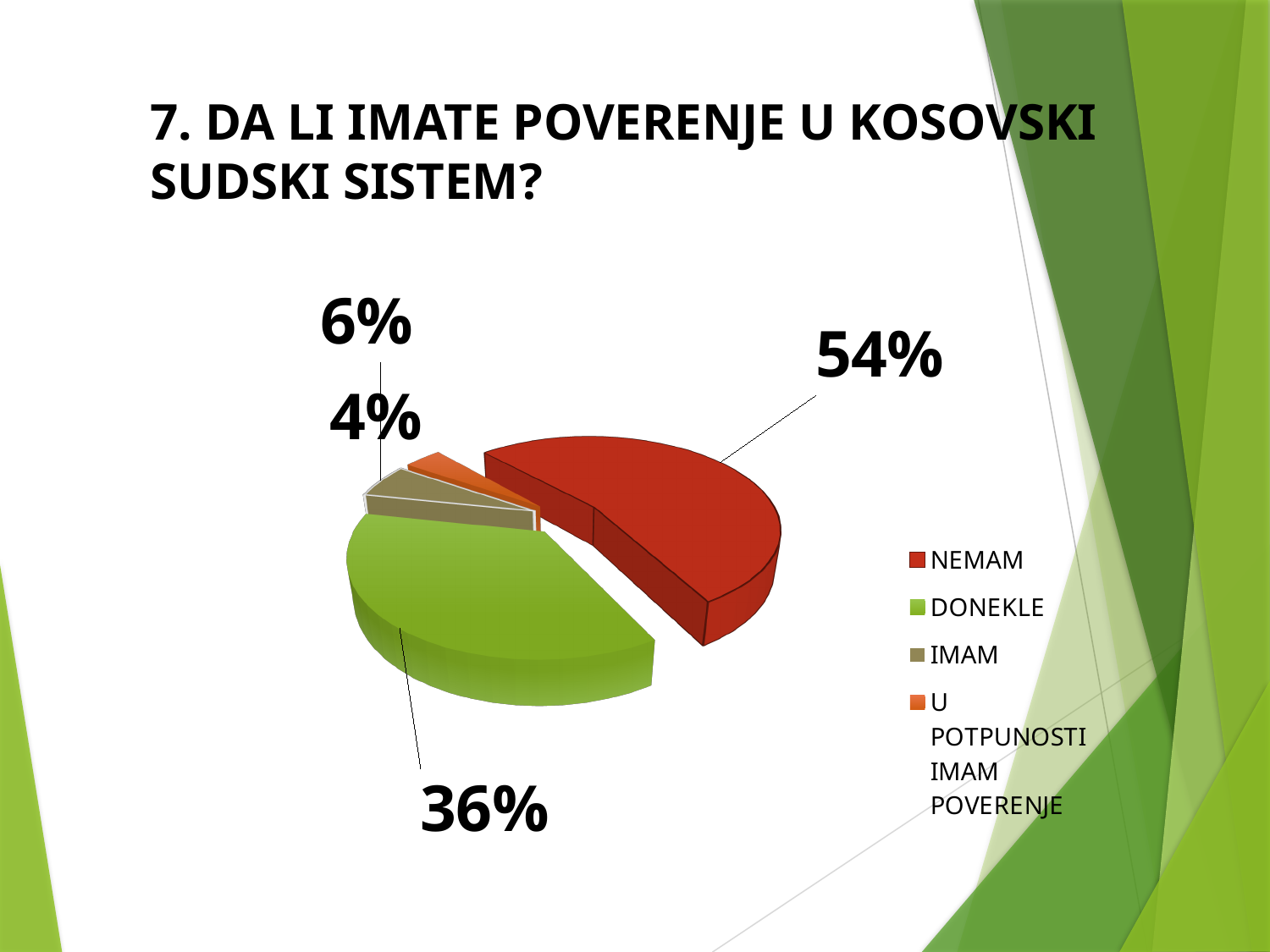
What percentage of respondents answered DONEKLE? 36% What colour is the NEMAM slice in the legend? Red What percentage of respondents answered NEMAM? 54% What is the difference in percentage points between the NEMAM and DONEKLE slices? 18 What kind of chart is shown on the slide? Pie chart Is the share for DONEKLE greater or less than 50%? less What share of the pie does the NEMAM slice represent? 54% What are the two smallest percentage values shown on the pie chart? 6% and 4% How many slices does the pie chart have? 4 What is the title of the chart on the slide? 7. DA LI IMATE POVERENJE U KOSOVSKI SUDSKI SISTEM? Which is larger, the NEMAM slice or the DONEKLE slice? NEMAM Which response category has the largest share of the pie? NEMAM